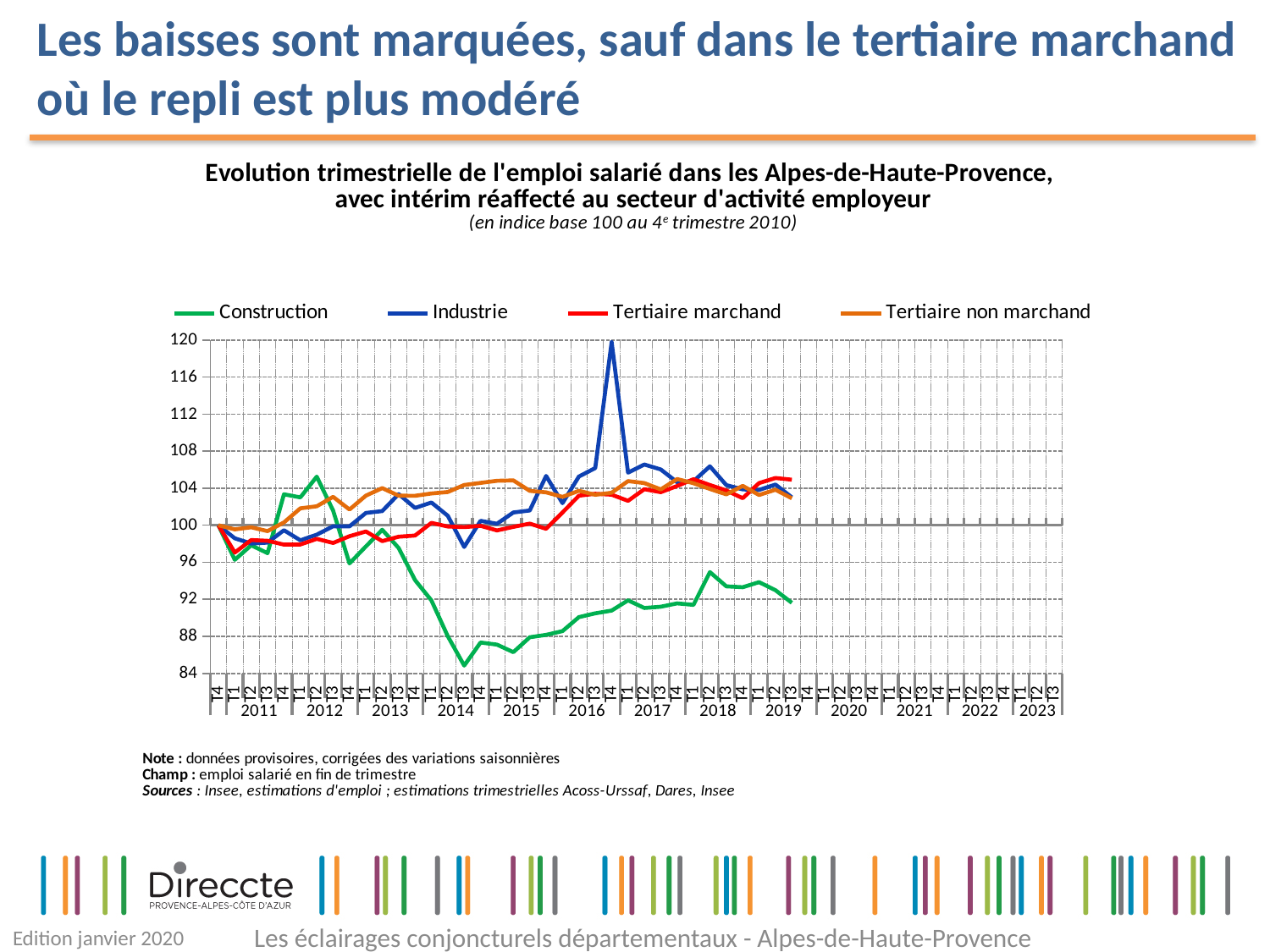
Is the value for Construction at T3 2014 greater or less than 88? less Is the value for Industrie at T4 2016 greater or less than 116? greater How many series does the legend list? 4 Which series has the lowest value at T3 2019? Construction Is the value for Tertiaire non marchand at T3 2019 greater or less than 100? greater What is the index value of all series at T4 2010, the base quarter? 100 Which series reaches the highest peak on the chart? Industrie Which series is drawn in green? Construction What type of chart is shown on the slide? line chart At T3 2019, which is higher: Tertiaire marchand or Construction? Tertiaire marchand Does the Construction series rise or fall between T2 2012 and T3 2014? fall